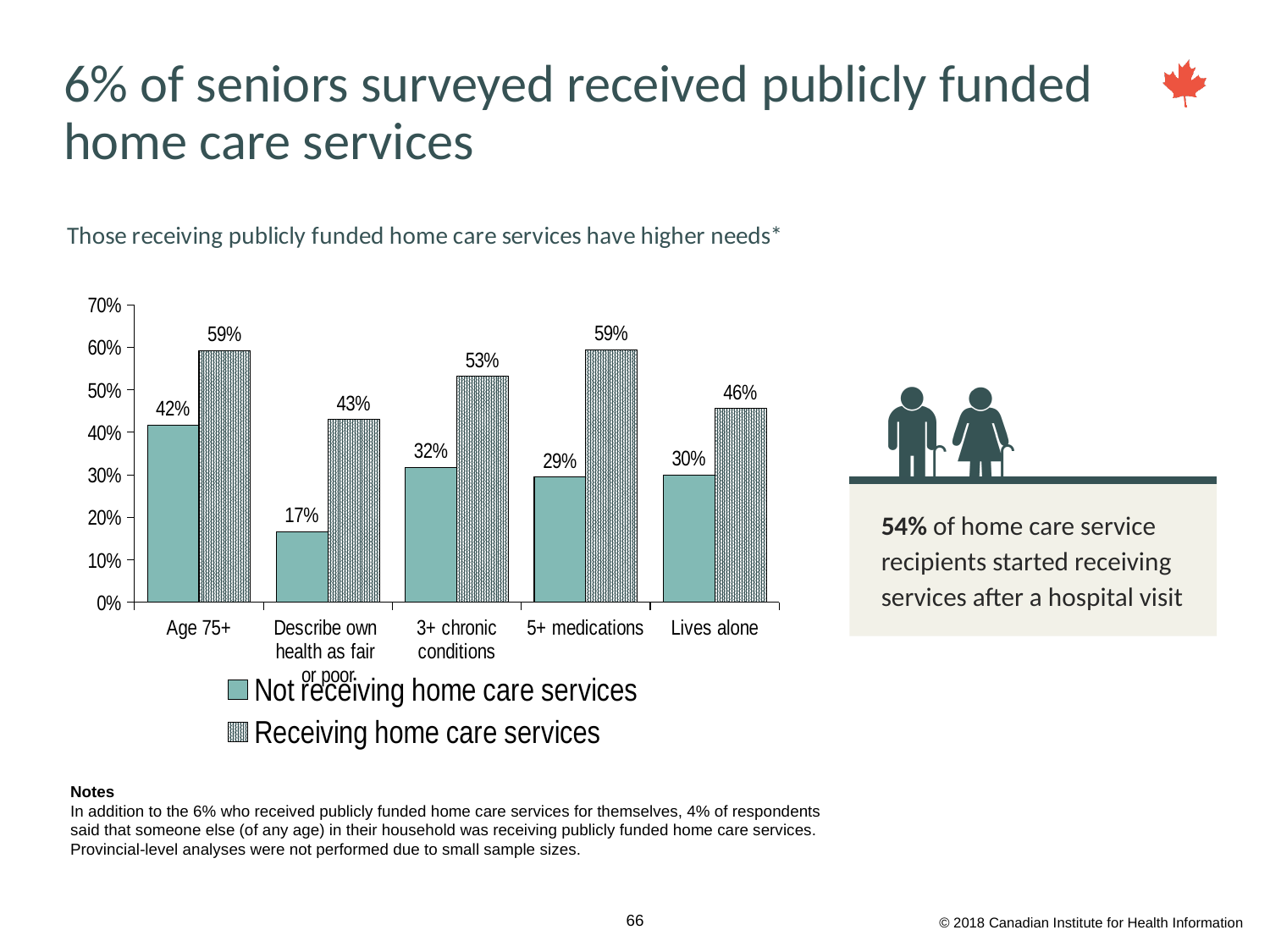
Which is larger for 'Lives alone': the 'Receiving home care services' value or the 'Not receiving home care services' value? Receiving home care services How many categories are shown on the x axis? 5 What is the difference between the 'Receiving' and 'Not receiving' values for 'Describe own health as fair or poor'? 26% What is the value for 'Age 75+' in the 'Receiving home care services' series? 59% What is the highest value shown on the y axis? 70% What is the difference between the 'Receiving' and 'Not receiving' values for '5+ medications'? 30% What kind of chart is shown on the slide? Bar chart Which category has the lowest value in the 'Not receiving home care services' series? Describe own health as fair or poor What is the value for '3+ chronic conditions' in the 'Receiving home care services' series? 53% What is the value for 'Lives alone' in the 'Not receiving home care services' series? 30% How many series does the legend list? 2 Which category has the lowest value in the 'Receiving home care services' series? Describe own health as fair or poor